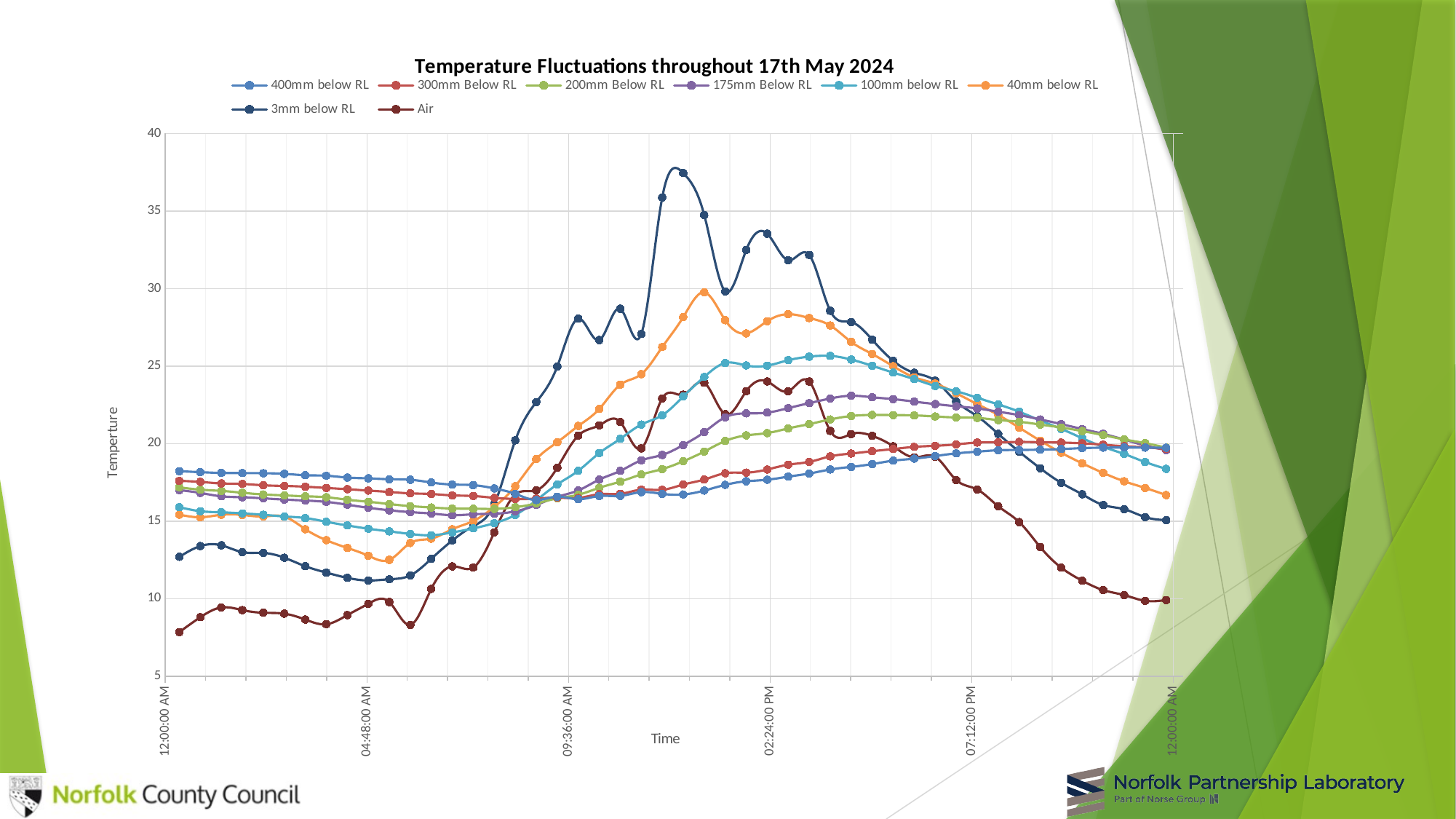
How many series does the legend list? 8 At 02:24:00 PM, which is higher: 3mm below RL or 200mm Below RL? 3mm below RL Which series reaches the highest temperature on the chart? 3mm below RL Is the peak value of the 100mm below RL series greater or less than 25? greater At 12:00:00 AM at the start of the chart, which is higher: 400mm below RL or Air? 400mm below RL Between 04:48:00 AM and 09:36:00 AM, does the 3mm below RL series rise or fall? rise What is the label on the horizontal axis of the chart? Time Is the value of the Air series at 12:00:00 AM at the start of the chart greater or less than 10? less Is the peak value of the 3mm below RL series greater or less than 35? greater What is the title of the chart? Temperature Fluctuations throughout 17th May 2024 What kind of chart is shown on the slide? line chart Which series reaches the lowest temperature on the chart? Air